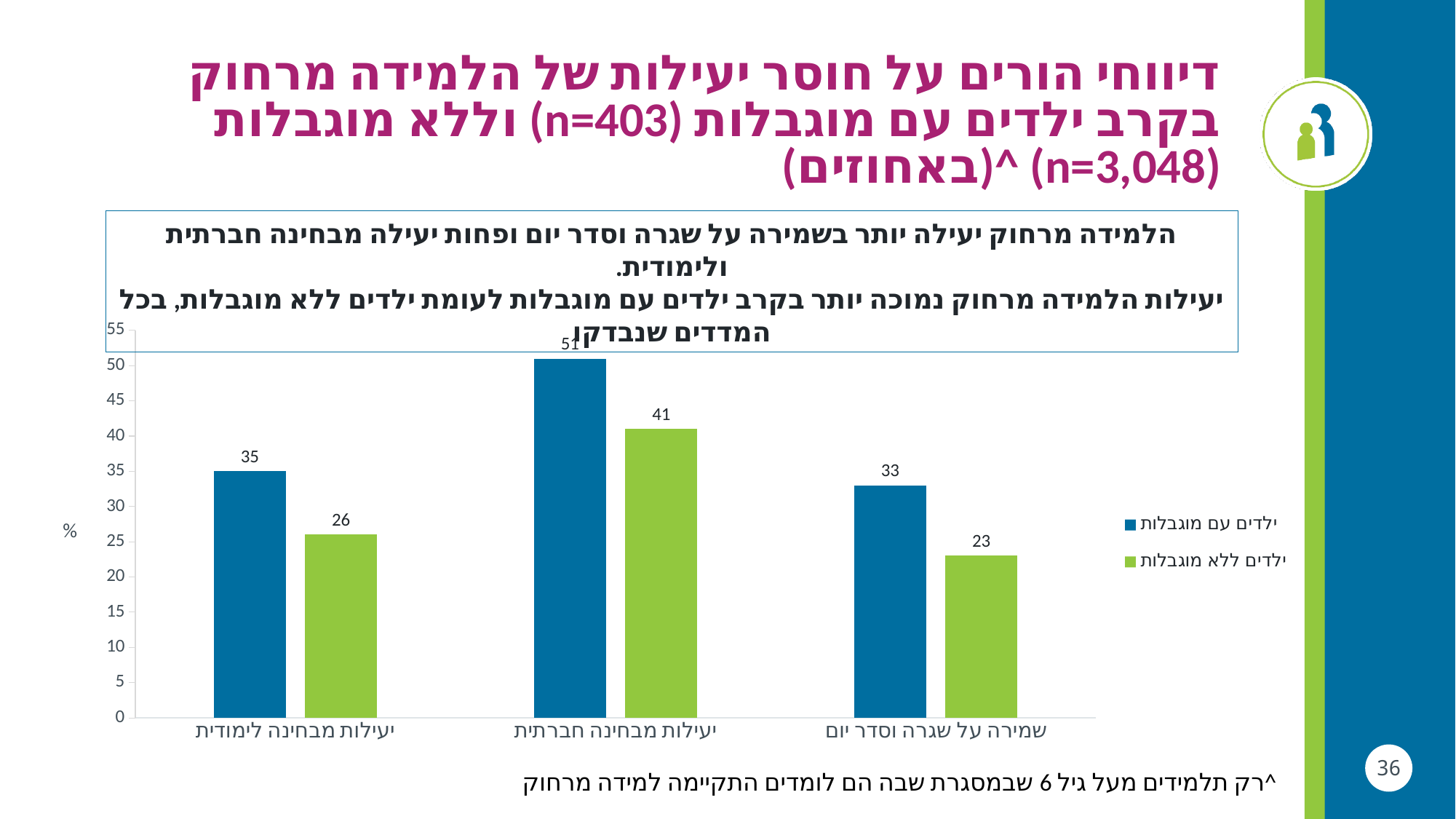
What is the value for ילדים ללא מוגבלות in the category יעילות מבחינה לימודית? 26 Which category has the highest value for ילדים עם מוגבלות? יעילות מבחינה חברתית What is the value for ילדים ללא מוגבלות in the category שמירה על שגרה וסדר יום? 23 How many series does the legend list? 2 Which category has the lowest value for ילדים ללא מוגבלות? שמירה על שגרה וסדר יום How many categories are shown on the x axis of the chart? 3 What is the value for ילדים עם מוגבלות in the category יעילות מבחינה חברתית? 51 What is the difference between ילדים עם מוגבלות and ילדים ללא מוגבלות in the category שמירה על שגרה וסדר יום? 10 Which colour represents ילדים ללא מוגבלות in the chart? green Which is larger in the category יעילות מבחינה לימודית: ילדים עם מוגבלות or ילדים ללא מוגבלות? ילדים עם מוגבלות What kind of chart is shown on the slide? bar chart What is the difference between ילדים עם מוגבלות and ילדים ללא מוגבלות in the category יעילות מבחינה חברתית? 10